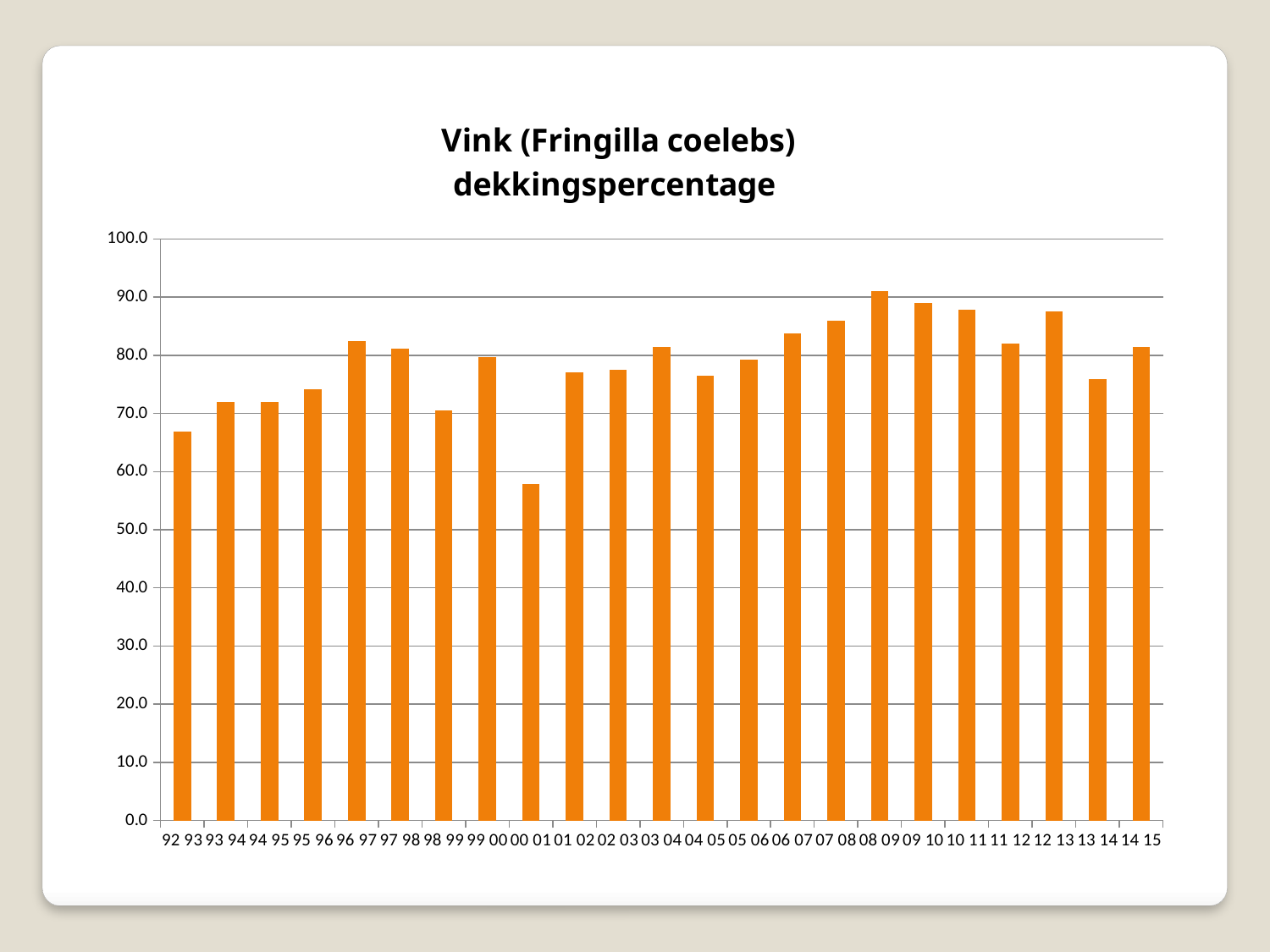
Which season has the highest dekkingspercentage? 08 09 What is the title of the chart? Vink (Fringilla coelebs) dekkingspercentage Is the value for 92 93 greater or less than 70? less How many bars (seasons) are plotted in the chart? 23 Which season has the lowest dekkingspercentage? 00 01 From 04 05 to 08 09, do the values rise or fall? rise Which season has the larger value, 12 13 or 13 14? 12 13 Is the value for 00 01 greater or less than 60? less Which season has the larger value, 96 97 or 98 99? 96 97 What type of chart is shown on the slide? bar chart Is the value for 08 09 greater or less than 90? greater